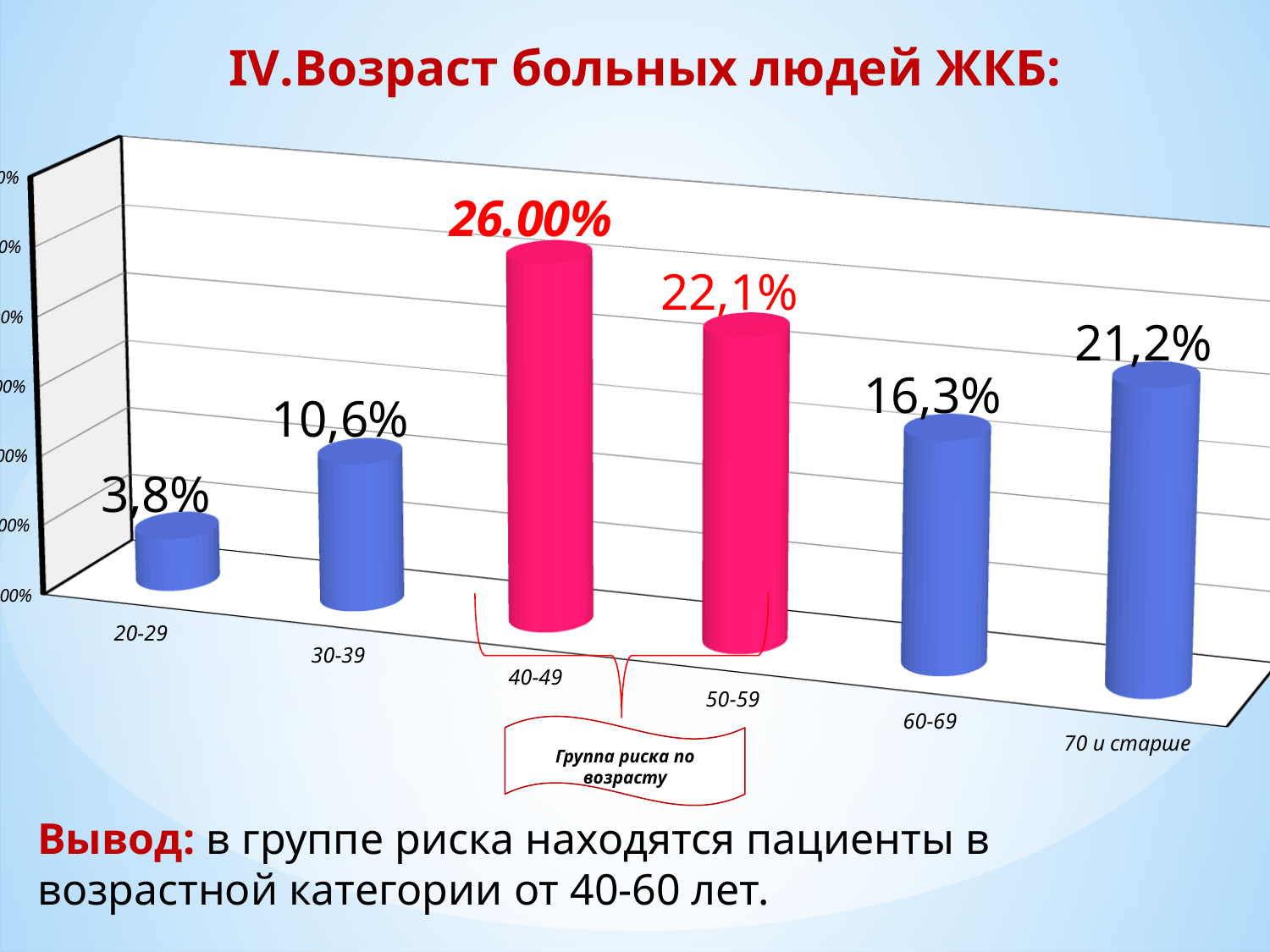
What is the value for the 60-69 age group? 16,3% What is the value for the 40-49 age group? 26.00% What kind of chart is shown on the slide? Bar chart Which age groups are highlighted in pink as the risk group? 40-49 and 50-59 What is the value for the 20-29 age group? 3,8% What is the difference between the values for 70 и старше and 60-69? 4,9% How many age groups are shown in the chart? 6 Which is larger, the value for 50-59 or the value for 70 и старше? 50-59 Which age group has the lowest value? 20-29 What is the value for the 70 и старше age group? 21,2% What is the difference between the values for 30-39 and 20-29? 6,8% Which age group has the highest value? 40-49